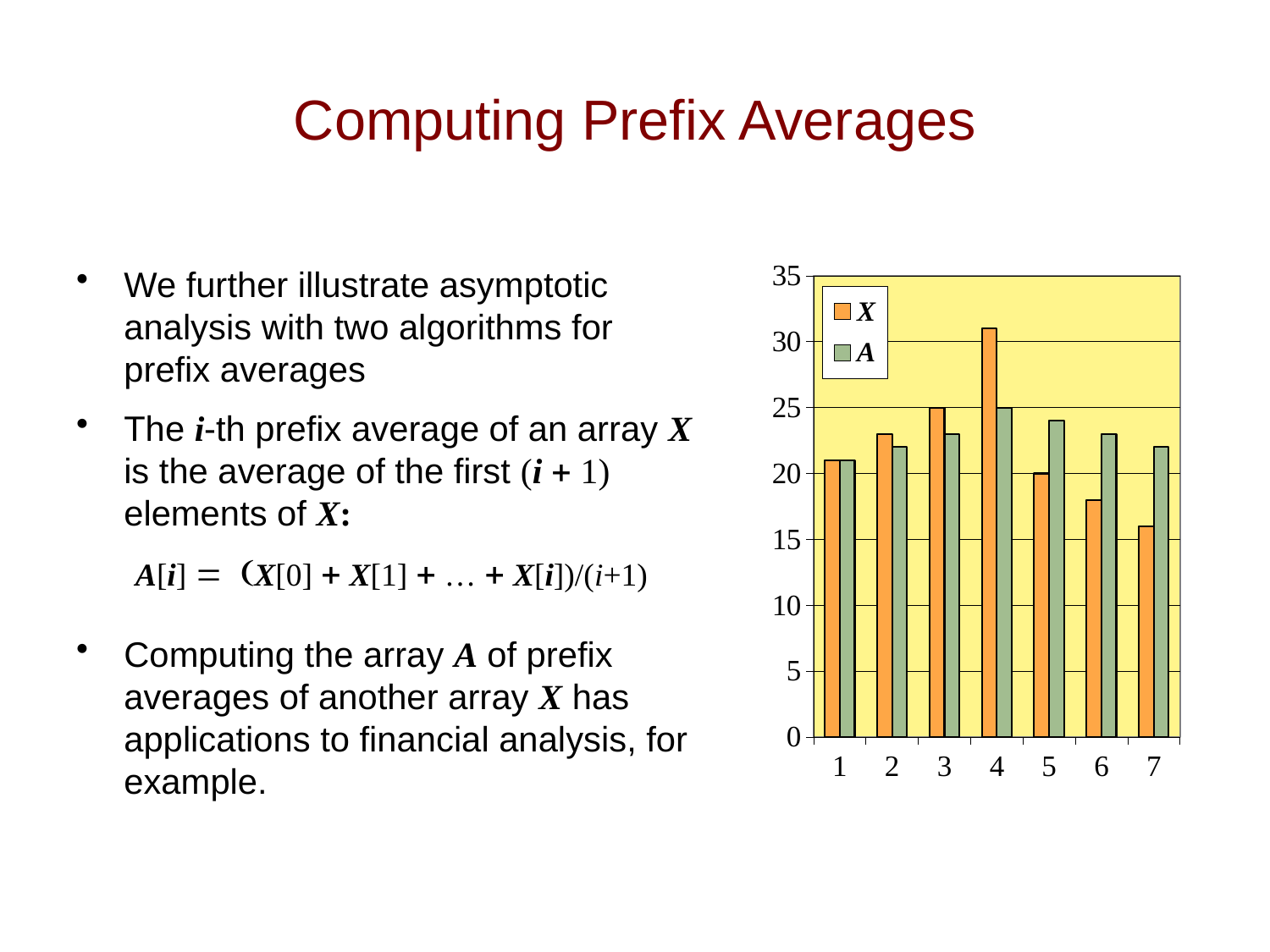
Is the value of X for category 7 greater or less than 20? less What are the two series names listed in the chart's legend? X and A At category 4, which series has the larger value, X or A? X Do the values of the X series rise or fall from category 4 to category 7? fall Is the value of A for category 6 greater or less than 20? greater For which category is the X series highest? 4 How many series does the chart's legend list? 2 What kind of chart is shown on the slide? bar chart Is the value of X for category 4 greater or less than 25? greater How many categories are shown along the x axis of the chart? 7 For which category is the X series lowest? 7 At category 7, which series has the larger value, X or A? A